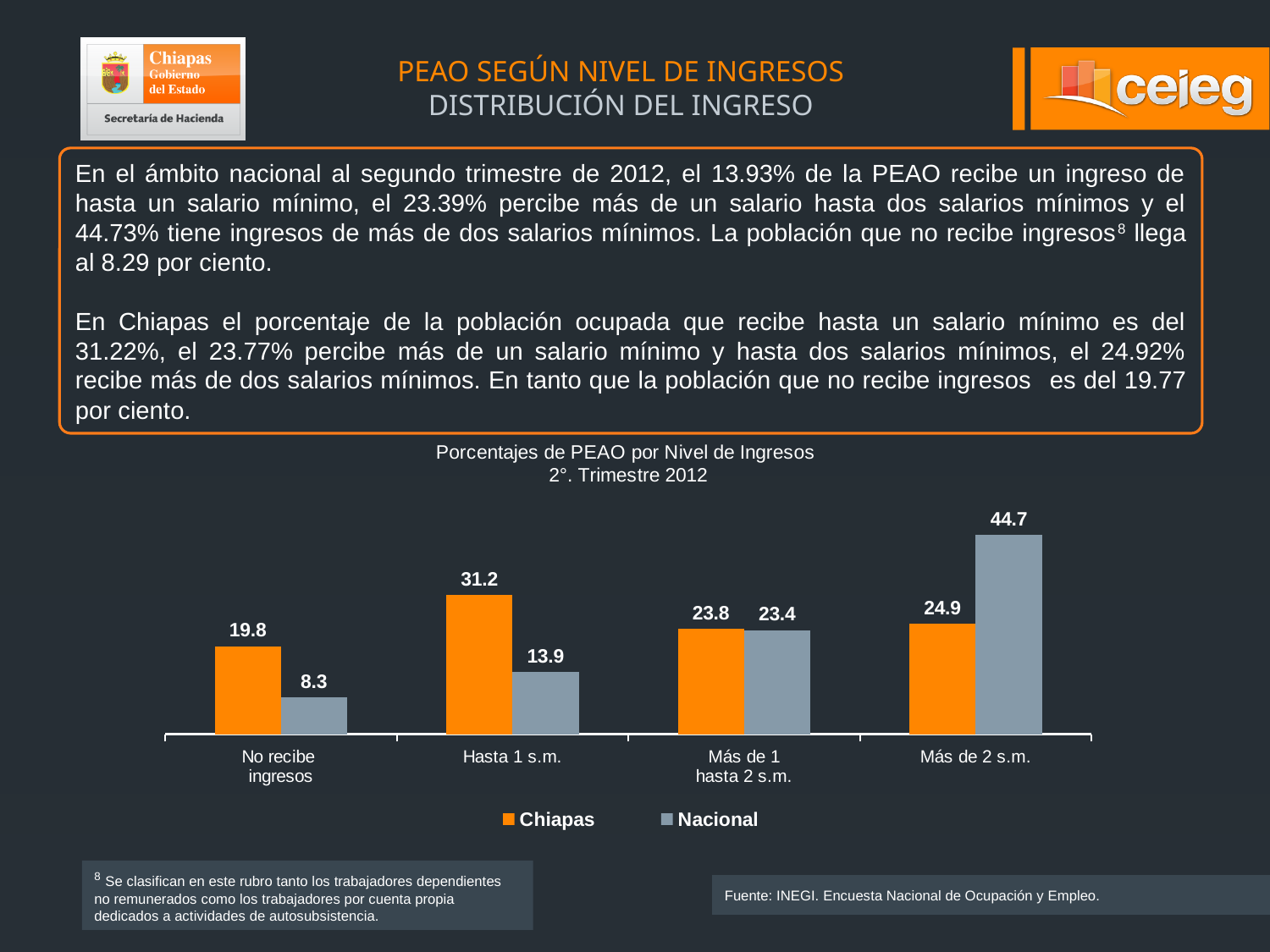
What kind of chart is shown on the slide? Bar chart How many series does the legend list? 2 What is the title of the chart? Porcentajes de PEAO por Nivel de Ingresos 2°. Trimestre 2012 What is the difference between the Chiapas and Nacional values for 'Hasta 1 s.m.'? 17.3 What is the Nacional value for 'Más de 2 s.m.'? 44.7 Which category has the highest Chiapas value? Hasta 1 s.m. Which is larger for 'No recibe ingresos', the Chiapas value or the Nacional value? Chiapas How many categories are shown on the x axis? 4 What is the Chiapas value for 'No recibe ingresos'? 19.8 Which category has the lowest Nacional value? No recibe ingresos What is the difference between the Nacional and Chiapas values for 'Más de 2 s.m.'? 19.8 What is the Nacional value for 'Hasta 1 s.m.'? 13.9